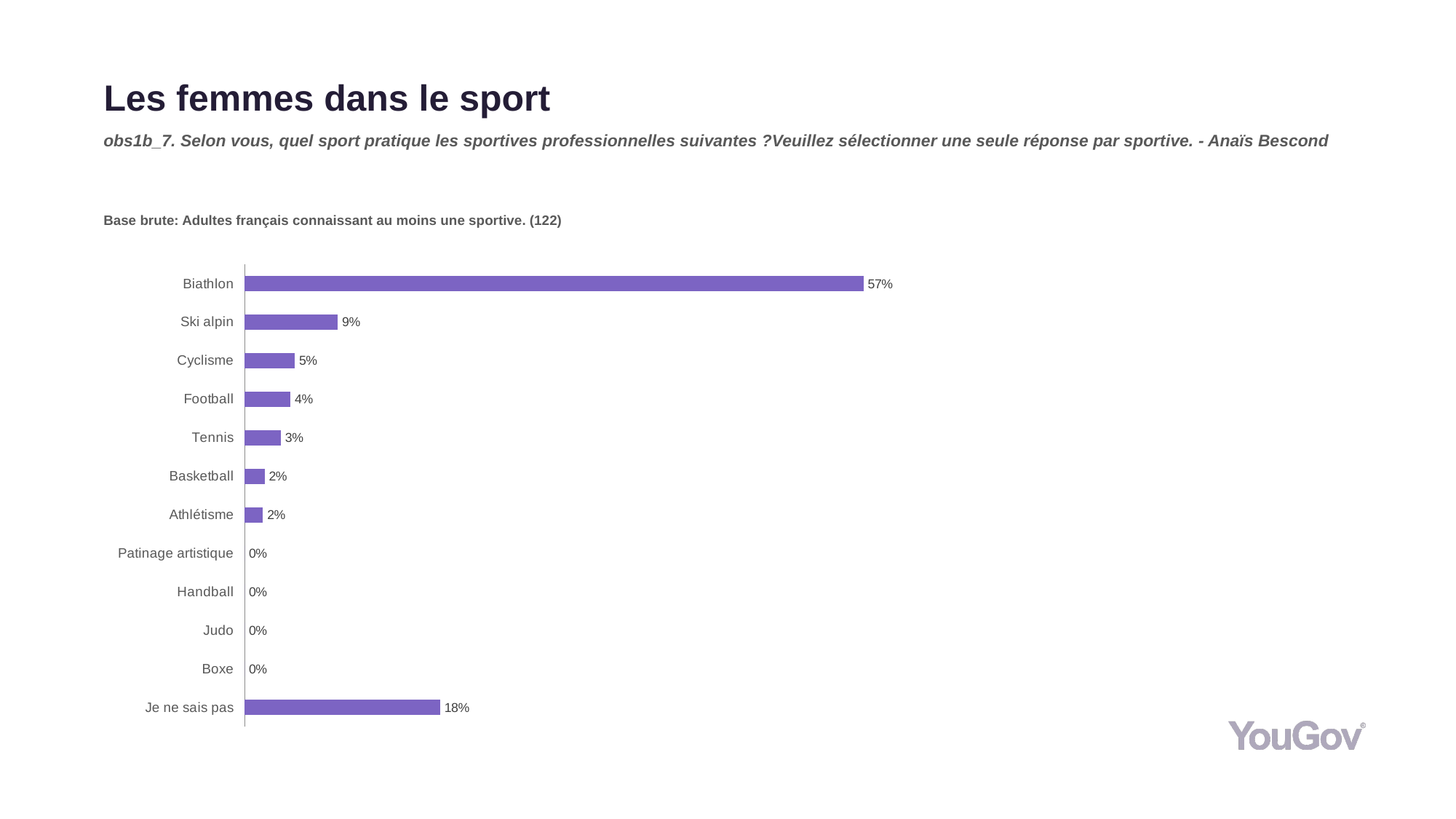
What is the title of the slide? Les femmes dans le sport How many categories have a value of 0%? 4 What is the value for Tennis? 3% What is the difference between the values for Biathlon and Je ne sais pas? 39% What is the value for Biathlon? 57% What kind of chart is shown on the slide? Bar chart What is the value for Ski alpin? 9% How many categories are shown on the chart? 12 What is the difference between the values for Ski alpin and Cyclisme? 4% Which category has the highest value? Biathlon Which is larger, the value for Football or the value for Tennis? Football What is the value for Je ne sais pas? 18%